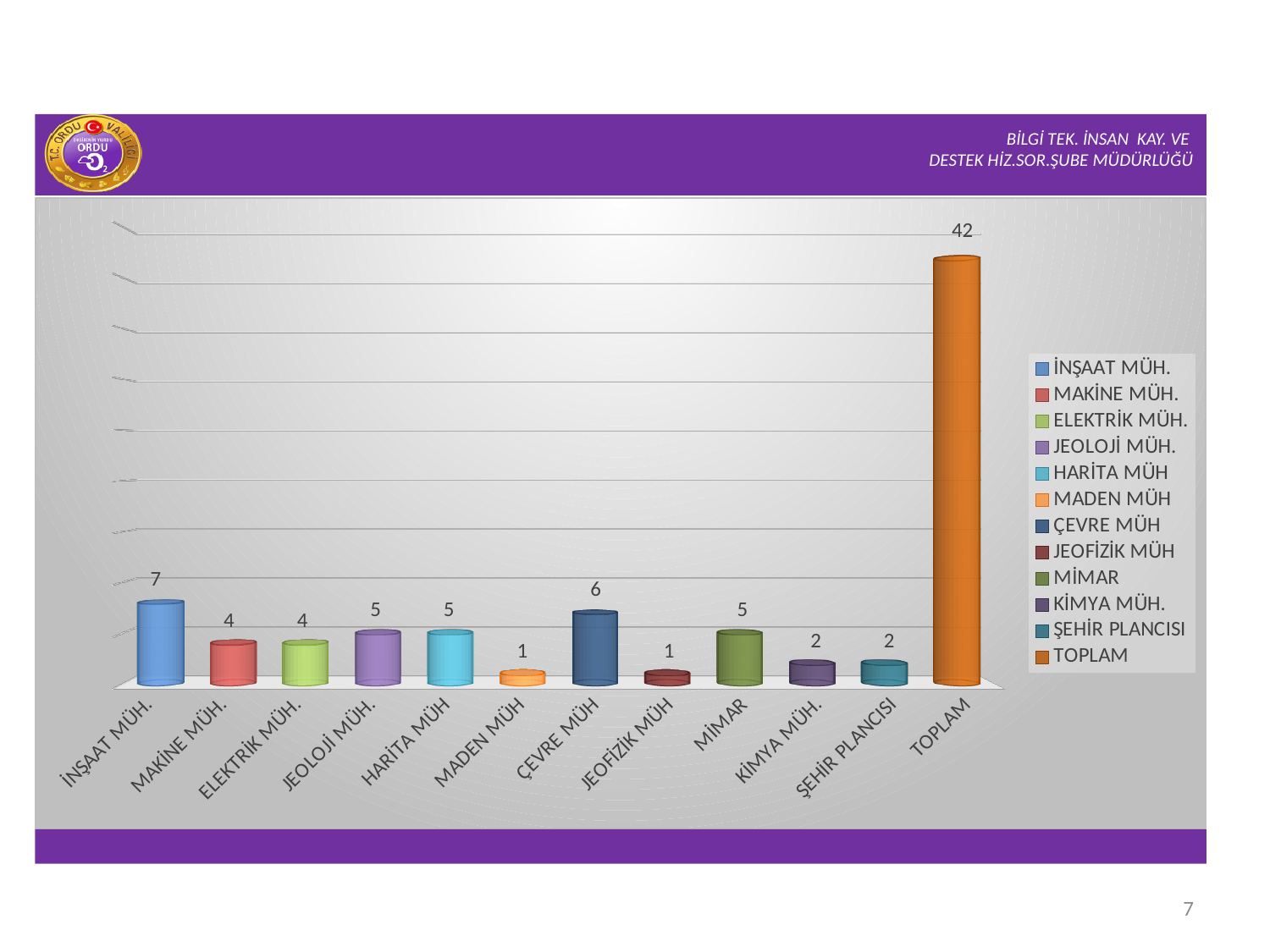
Which categories have the lowest value? MADEN MÜH and JEOFİZİK MÜH How many entries does the legend list? 12 Which is larger, the value for ÇEVRE MÜH or the value for MİMAR? ÇEVRE MÜH What is the value for İNŞAAT MÜH.? 7 What is the difference between the values for İNŞAAT MÜH. and MAKİNE MÜH.? 3 Excluding the TOPLAM bar, which category has the highest value? İNŞAAT MÜH. How many categories are shown on the x axis? 12 What kind of chart is shown on the slide? Bar chart What colour is the TOPLAM bar? Orange What is the value for ÇEVRE MÜH? 6 What is the value for ŞEHİR PLANCISI? 2 What is the value shown for TOPLAM? 42